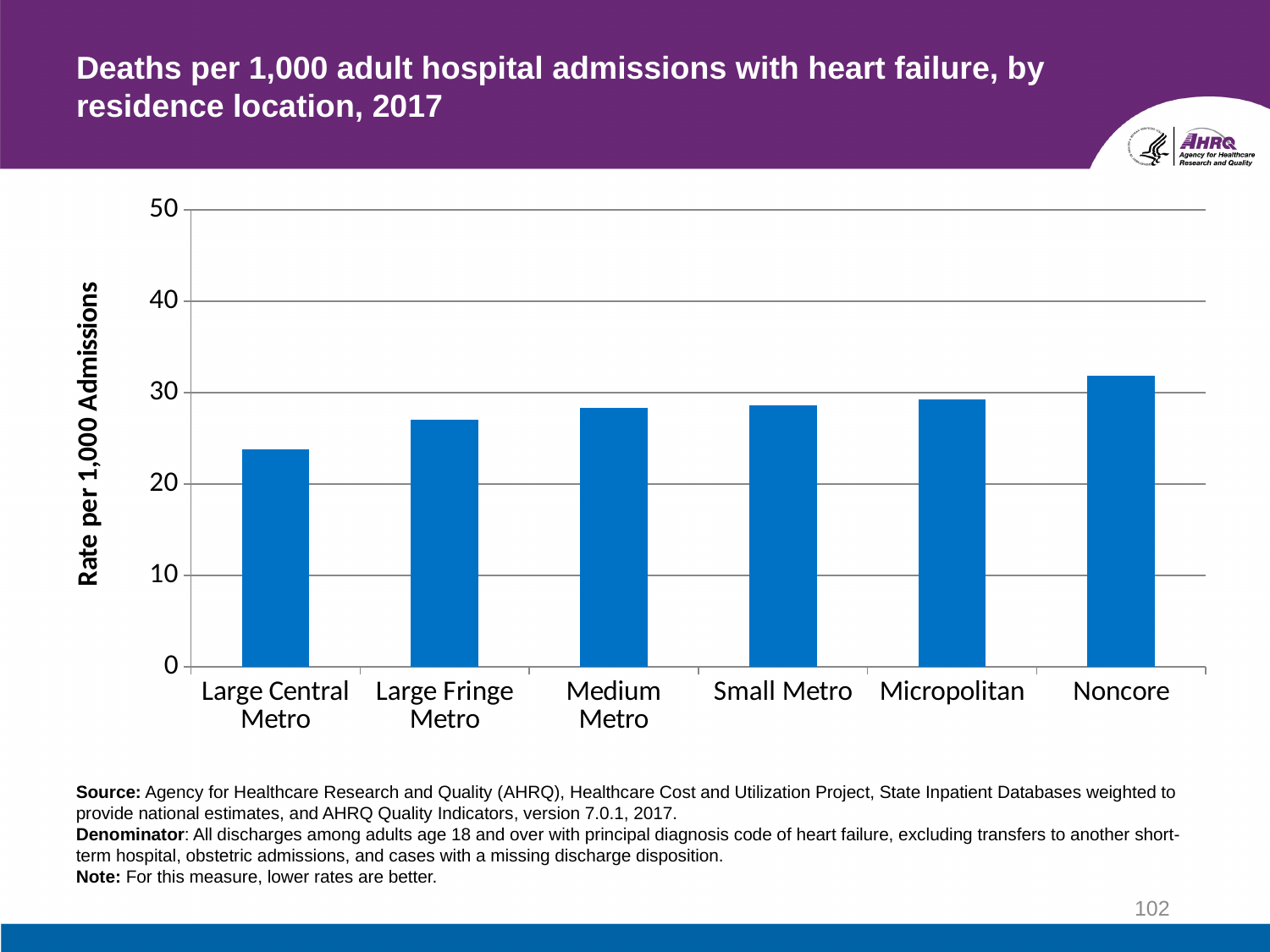
Which residence location has the lowest death rate per 1,000 admissions? Large Central Metro Is the value for Large Fringe Metro greater or less than 30? less What kind of chart is shown on the slide? bar chart Which is larger, the value for Noncore or the value for Large Central Metro? Noncore Which is larger, the value for Large Fringe Metro or the value for Micropolitan? Micropolitan Do the values rise or fall moving from Large Central Metro to Noncore along the x axis? rise Is the value for Noncore greater or less than 40? less How many residence location categories are shown on the x axis? 6 Is the value for Large Central Metro greater or less than 20? greater Which residence location has the highest death rate per 1,000 admissions? Noncore What is the label on the y axis of the chart? Rate per 1,000 Admissions